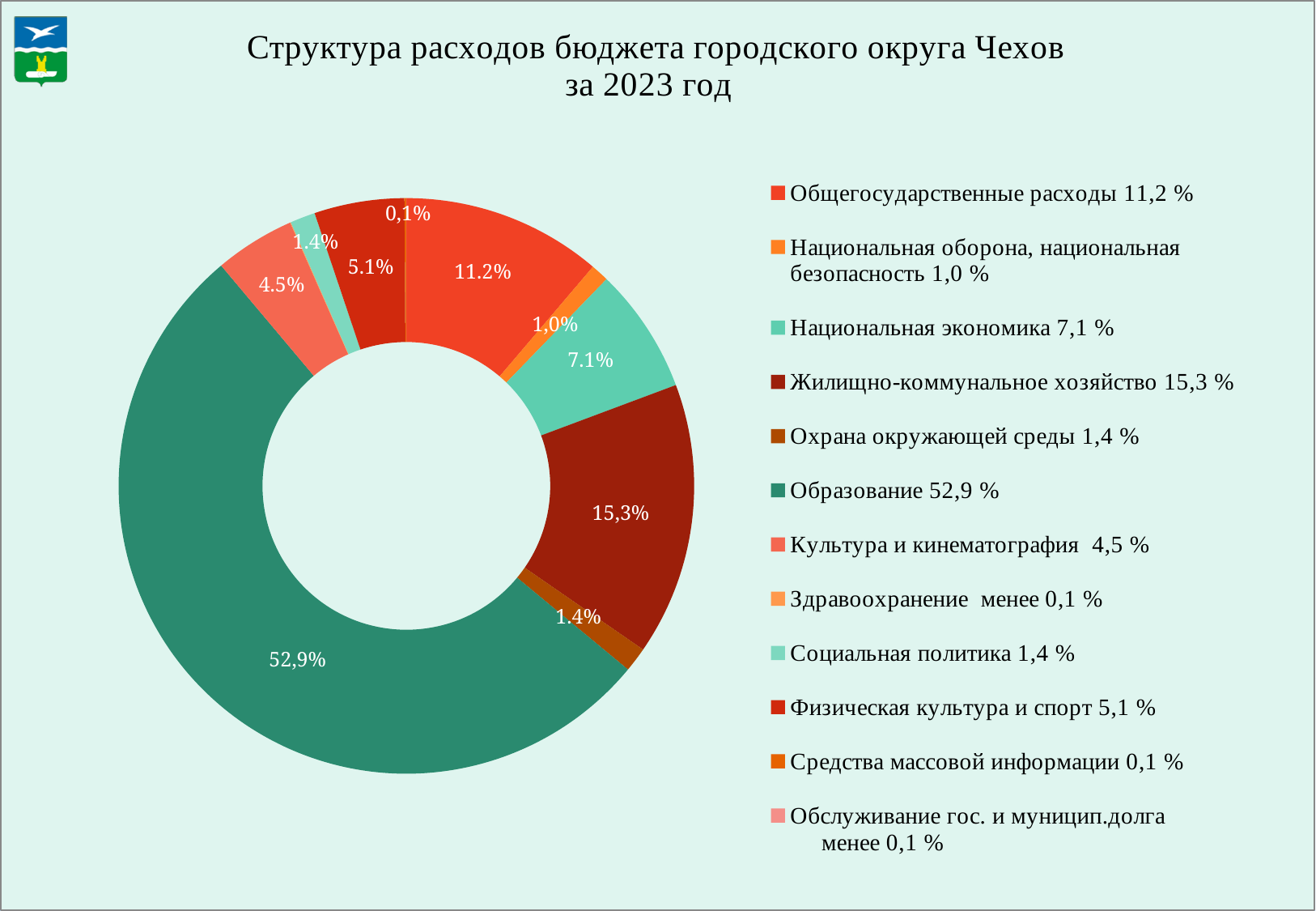
How many expenditure categories does the legend list? 12 What is the difference between the shares of Образование and Жилищно-коммунальное хозяйство? 37,6% What is the title of the chart? Структура расходов бюджета городского округа Чехов за 2023 год What is the value for Культура и кинематография? 4.5% What is the value for Национальная экономика? 7.1% What kind of chart is shown on the slide? Pie (donut) chart Which is larger: Общегосударственные расходы or Жилищно-коммунальное хозяйство? Жилищно-коммунальное хозяйство What share of the budget expenditure goes to Образование? 52,9% What is the difference between the shares of Общегосударственные расходы and Национальная экономика? 4.1% Which expenditure category has the largest share? Образование What is the value for Физическая культура и спорт? 5.1% What is the value for Жилищно-коммунальное хозяйство? 15,3%